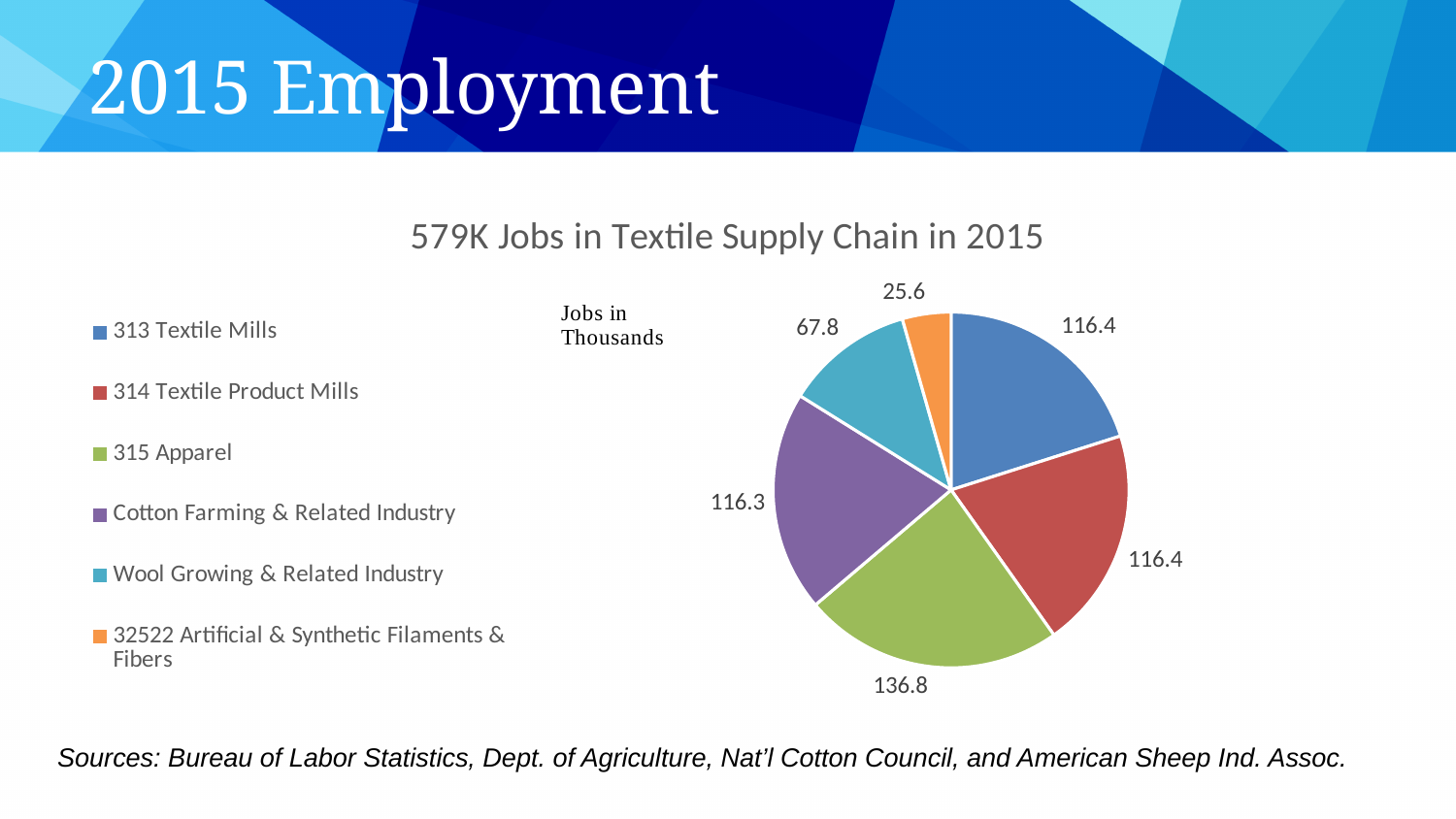
How many categories does the pie chart have? 6 What is the value for Wool Growing & Related Industry? 67.8 What is the difference between the values for 315 Apparel and Wool Growing & Related Industry? 69.0 What is the title of the chart? 579K Jobs in Textile Supply Chain in 2015 What unit are the values in the pie chart expressed in, according to the label next to the chart? Jobs in Thousands Which category has the smallest slice of the pie? 32522 Artificial & Synthetic Filaments & Fibers What is the value for 315 Apparel? 136.8 What is the value for Cotton Farming & Related Industry? 116.3 Which is larger, the value for Wool Growing & Related Industry or the value for 32522 Artificial & Synthetic Filaments & Fibers? Wool Growing & Related Industry Which category has the largest slice of the pie? 315 Apparel What is the value for 32522 Artificial & Synthetic Filaments & Fibers? 25.6 What kind of chart is shown on the slide? Pie chart